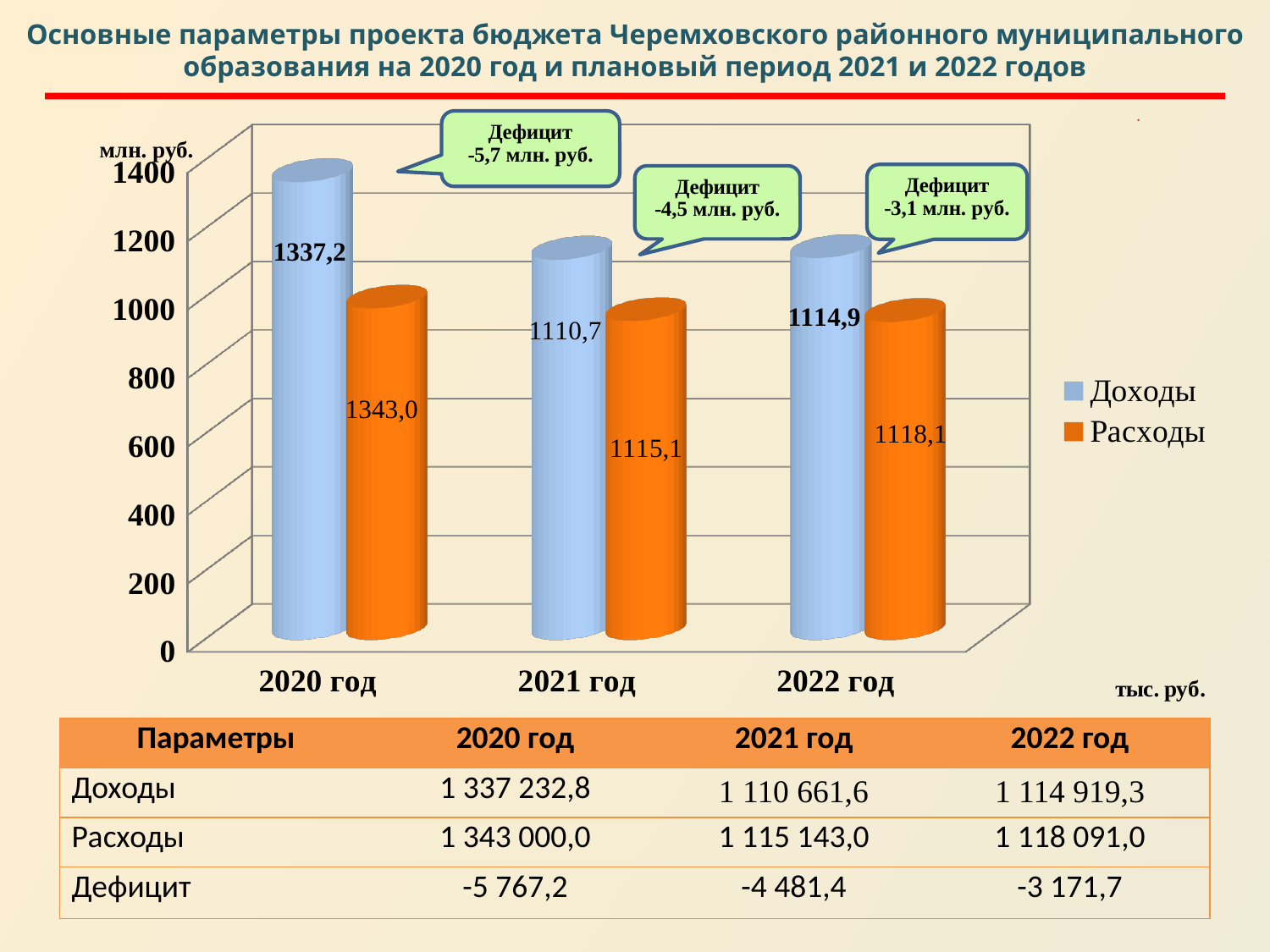
In which year is Расходы highest? 2020 год How many series does the chart legend list? 2 What is the value of Расходы for 2022 год? 1118,1 How many years are shown on the x axis of the chart? 3 What is the value of Доходы for 2020 год? 1337,2 What is the difference between Доходы in 2020 год and Доходы in 2021 год? 226,5 What kind of chart is shown on the slide? bar chart What is the value of Расходы for 2021 год? 1115,1 In which year is Доходы lowest? 2021 год Do the Расходы values rise or fall from 2020 год to 2021 год? fall Is the value of Доходы for 2021 год greater or less than 1000? greater